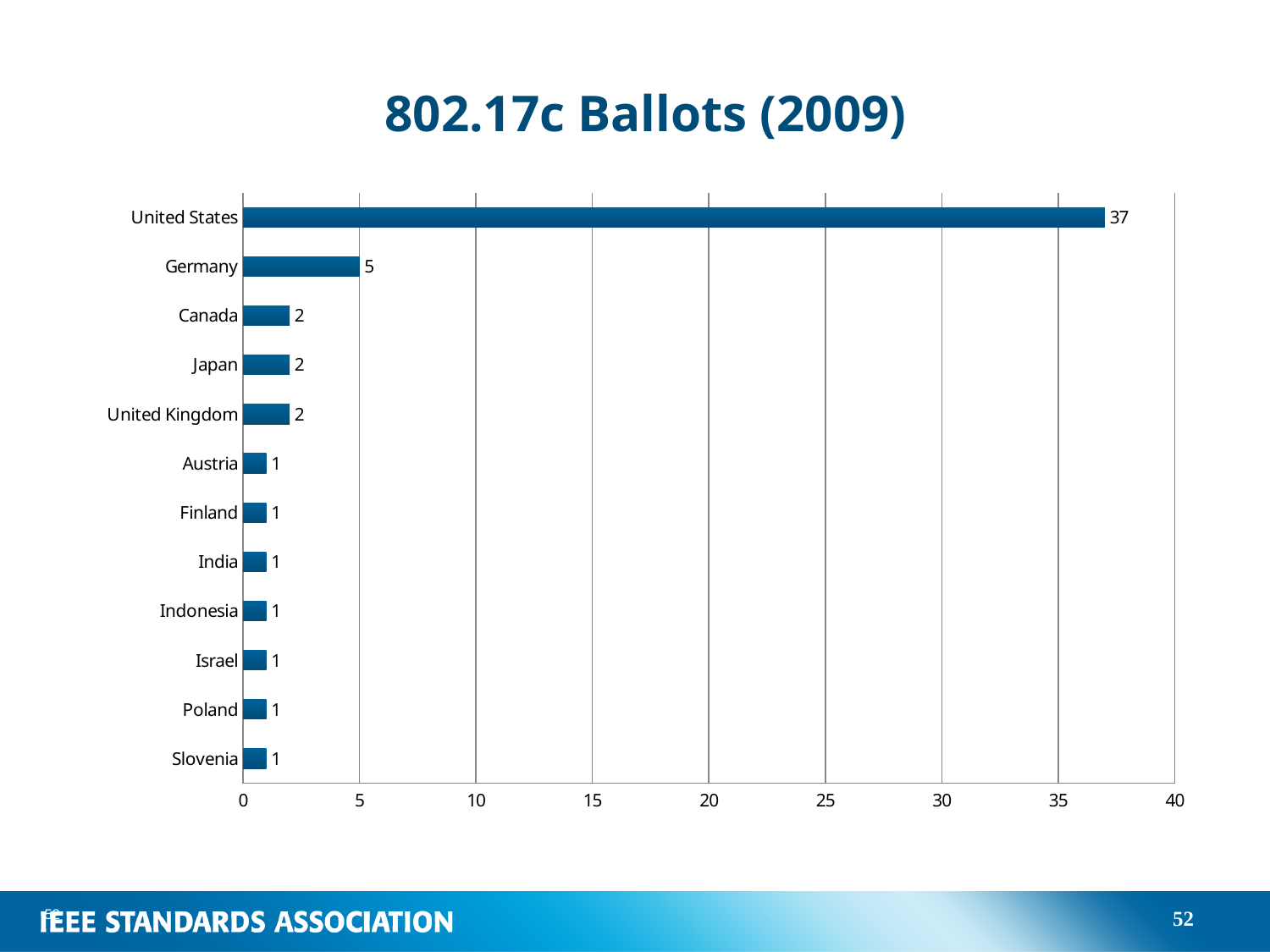
Which is larger, the value for Germany or the value for United Kingdom? Germany Which country has the highest value? United States What is the value for Canada? 2 Is the value for United States greater or less than 35? greater What is the difference between the values for Germany and Japan? 3 What is the value for Slovenia? 1 What is the title of the chart? 802.17c Ballots (2009) How many countries are shown on the chart? 12 What is the value for United States? 37 What is the difference between the values for United States and Germany? 32 What is the value for Germany? 5 What kind of chart is shown on the slide? bar chart